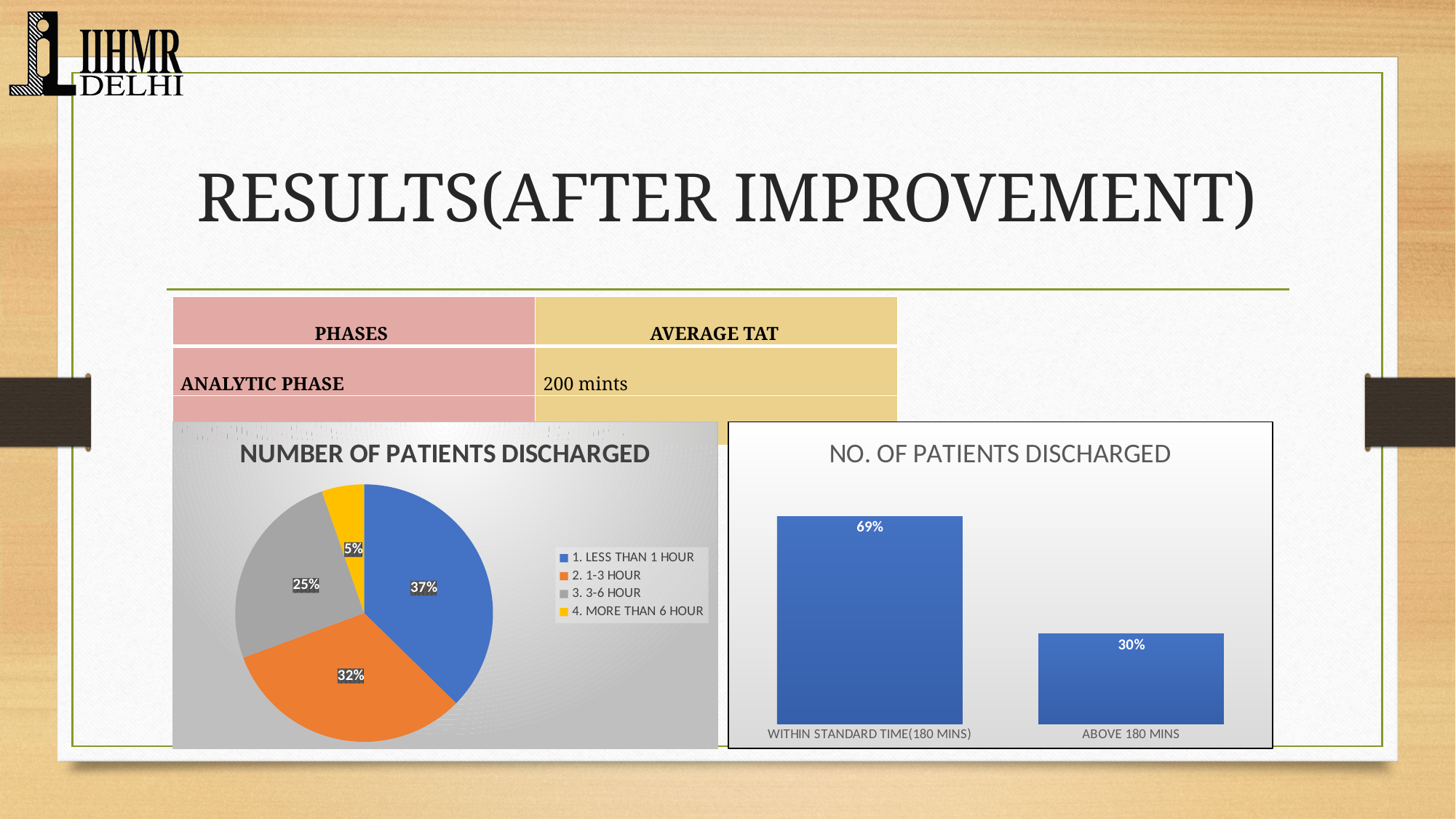
In the pie chart titled "NUMBER OF PATIENTS DISCHARGED", which category has the smallest slice? 4. MORE THAN 6 HOUR In the pie chart titled "NUMBER OF PATIENTS DISCHARGED", what colour is the slice for "2. 1-3 HOUR"? Orange In the pie chart titled "NUMBER OF PATIENTS DISCHARGED", what share is shown for "3. 3-6 HOUR"? 25% In the pie chart titled "NUMBER OF PATIENTS DISCHARGED", how many categories does the legend list? 4 What kind of chart is the one titled "NO. OF PATIENTS DISCHARGED" on the right of the slide? Bar chart In the pie chart titled "NUMBER OF PATIENTS DISCHARGED", which category has the largest slice? 1. LESS THAN 1 HOUR In the pie chart titled "NUMBER OF PATIENTS DISCHARGED", what is the difference between the shares for "2. 1-3 HOUR" and "4. MORE THAN 6 HOUR"? 27% In the bar chart titled "NO. OF PATIENTS DISCHARGED", what is the difference between the two bars? 39% In the bar chart titled "NO. OF PATIENTS DISCHARGED", which category has the higher value? WITHIN STANDARD TIME(180 MINS) In the bar chart titled "NO. OF PATIENTS DISCHARGED", what is the value for "ABOVE 180 MINS"? 30% In the pie chart titled "NUMBER OF PATIENTS DISCHARGED", what share is shown for "1. LESS THAN 1 HOUR"? 37% In the bar chart titled "NO. OF PATIENTS DISCHARGED", what is the value for "WITHIN STANDARD TIME(180 MINS)"? 69%